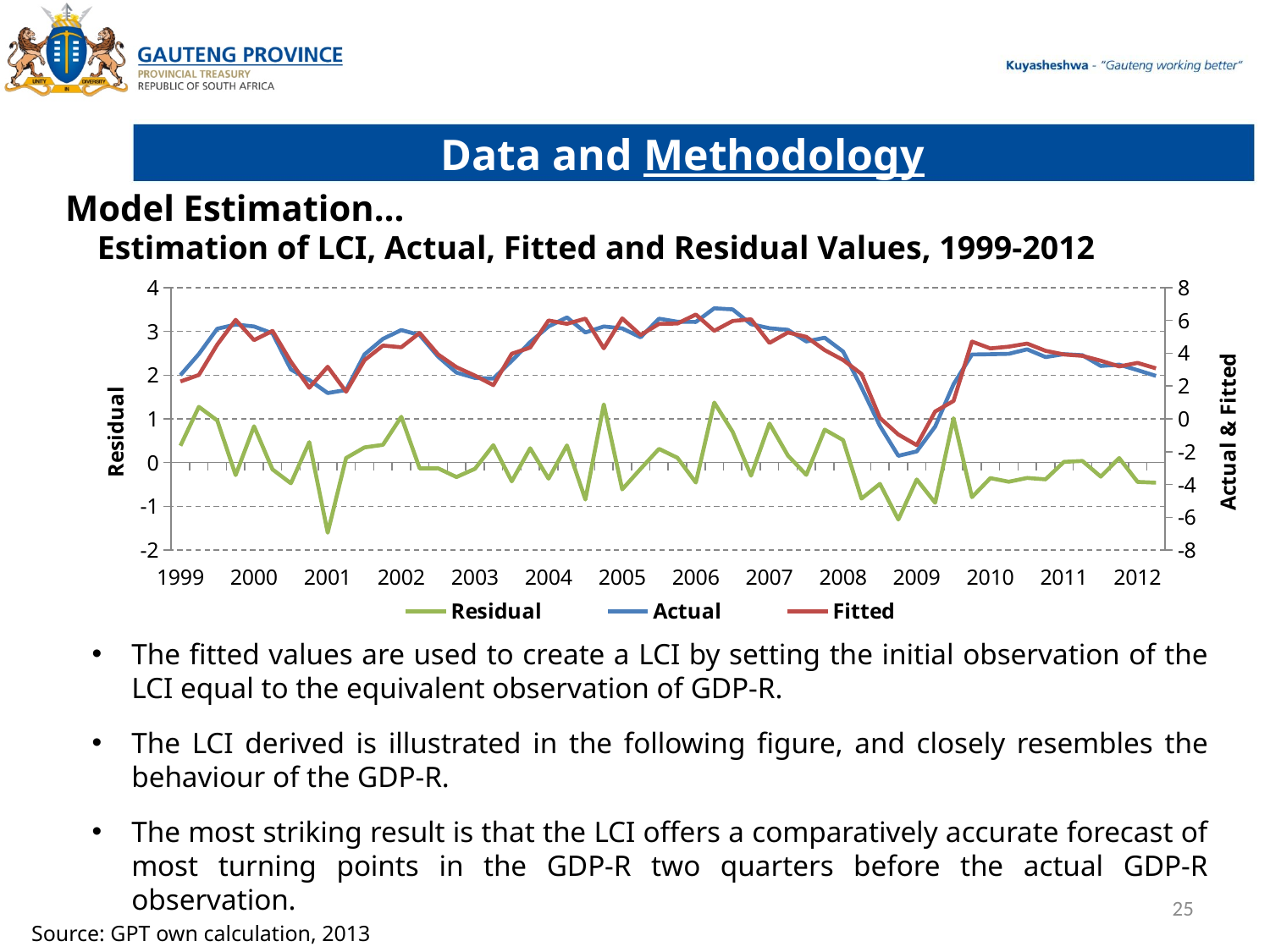
How many series does the chart legend list? 3 Is the lowest Actual value in 2009 greater or less than 0 on the right axis? less Does the Actual series rise or fall between early 2009 and 2010? rise Is the lowest Residual value in 2001 greater or less than -1 on the left axis? less Does the Actual series rise or fall between 2008 and early 2009? fall Is the peak Actual value in 2006 greater or less than 4 on the right axis? greater What is the label of the right-hand vertical axis of the chart? Actual & Fitted What are the three series named in the chart legend? Residual, Actual, Fitted How many years are labelled along the x axis of the chart? 14 Which is higher in 2009: the lowest point of the Actual series or the lowest point of the Residual series, as read on their respective axes? Residual What kind of chart is shown on the slide? Line chart In which year does the Residual series reach its lowest point? 2001